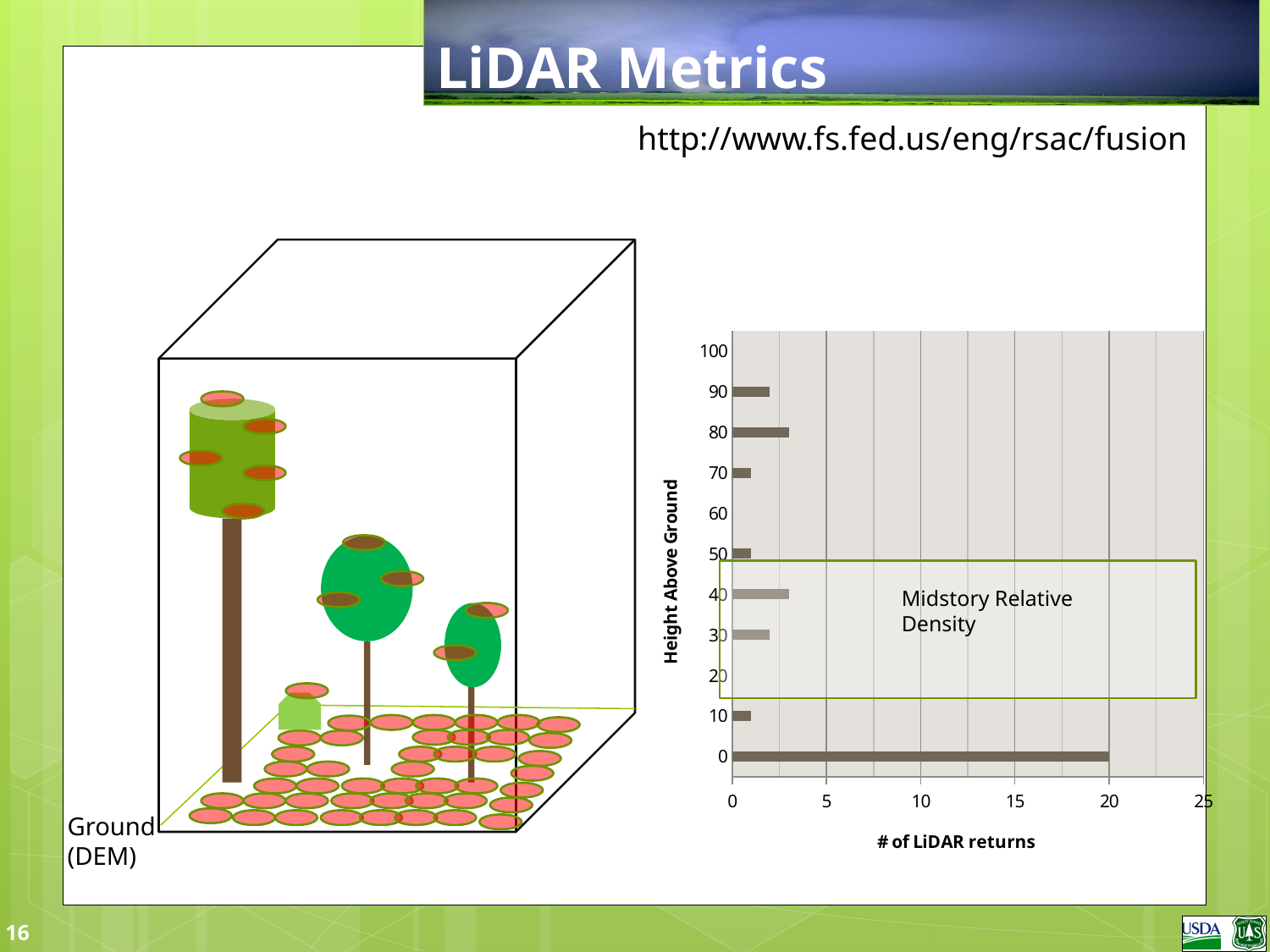
What kind of chart is shown on the slide? bar chart Is the number of LiDAR returns for height above ground 80 greater or less than 5? less Which has more LiDAR returns, height above ground 0 or height above ground 90? 0 Which height above ground has the highest number of LiDAR returns? 0 What is the title of the y axis of the chart? Height Above Ground Is the number of LiDAR returns for height above ground 40 greater or less than 5? less Is the number of LiDAR returns for height above ground 10 greater or less than 5? less Which has more LiDAR returns, height above ground 80 or height above ground 70? 80 How many height categories are shown on the y axis of the chart? 11 What is the title of the x axis of the chart? # of LiDAR returns What is the number of LiDAR returns for height above ground 0? 20